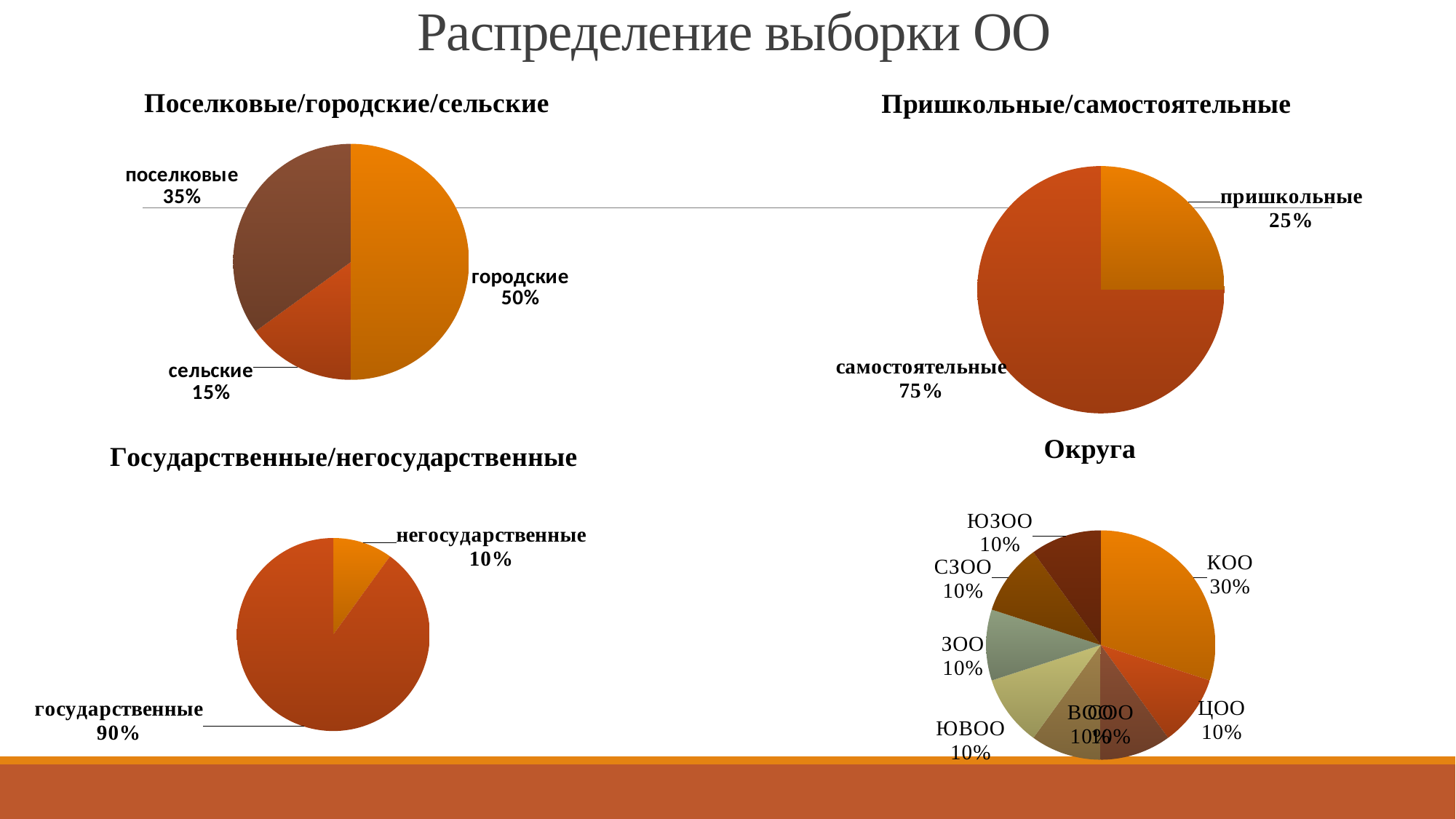
In the chart titled "Поселковые/городские/сельские", how many categories are shown? 3 In the chart titled "Государственные/негосударственные", how many percentage points larger is государственные than негосударственные? 80 percentage points In the chart titled "Поселковые/городские/сельские", how many percentage points larger is поселковые than сельские? 20 percentage points In the chart titled "Государственные/негосударственные", what share is labelled for негосударственные? 10% In the chart titled "Поселковые/городские/сельские", what share is labelled for сельские? 15% In the chart titled "Поселковые/городские/сельские", which category has the smallest share? сельские In the chart titled "Пришкольные/самостоятельные", which is larger: пришкольные or самостоятельные? самостоятельные In the chart titled "Пришкольные/самостоятельные", what share is labelled for самостоятельные? 75% In the chart titled "Поселковые/городские/сельские", which category has the largest share? городские What type of chart is used for the chart titled "Округа"? Pie chart In the chart titled "Округа", what share is labelled for КОО? 30% In the chart titled "Поселковые/городские/сельские", what share is labelled for городские? 50%